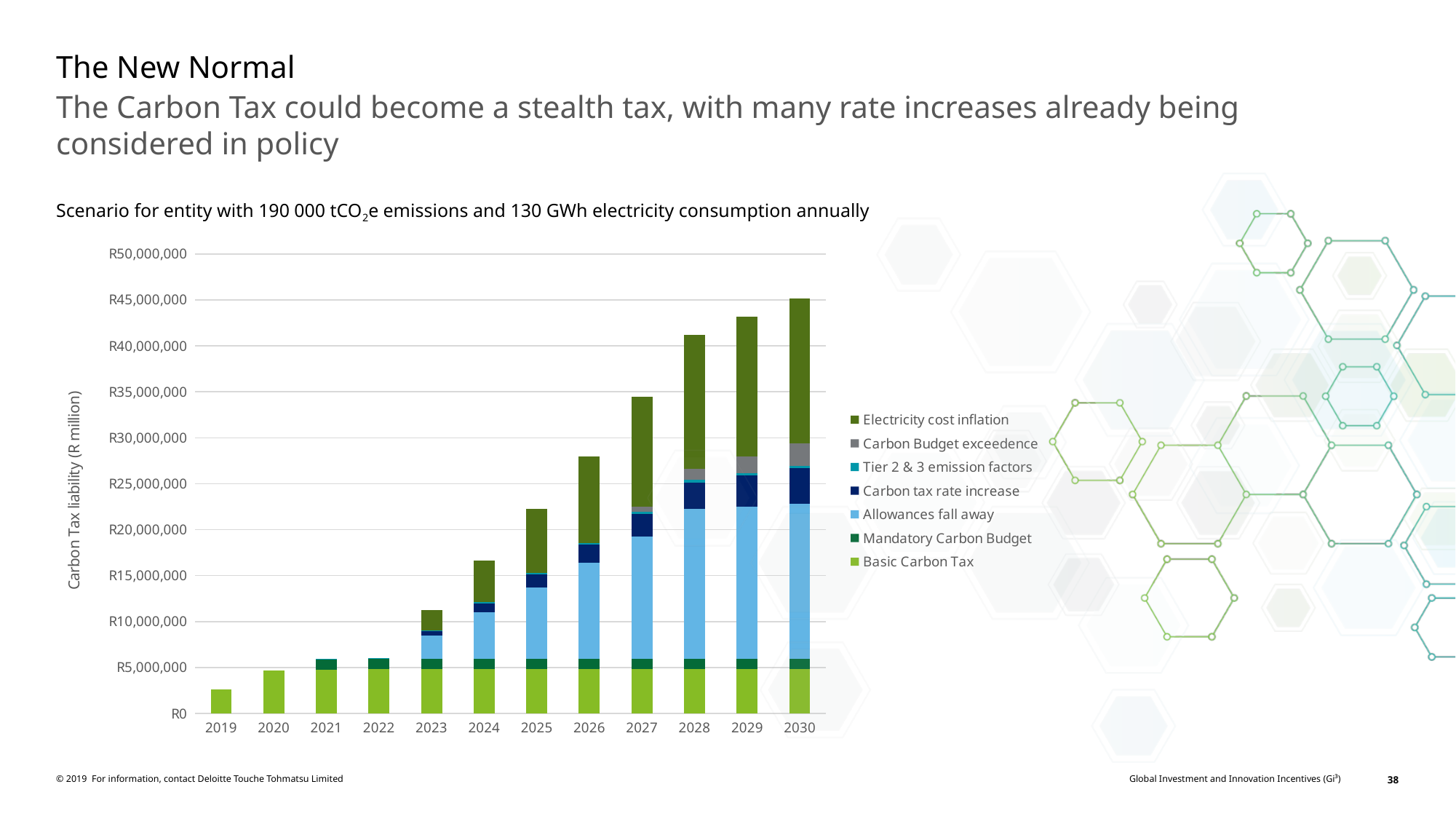
Which year has the lowest total Carbon Tax liability? 2019 Is the total value for 2028 greater or less than R40,000,000? greater Is the total value for 2026 greater or less than R25,000,000? greater Which series is listed first in the chart's legend? Electricity cost inflation What kind of chart is shown on the slide? Stacked bar chart Do the total bar heights rise or fall from 2019 to 2030? Rise Which year has the highest total Carbon Tax liability? 2030 Which year has the larger total Carbon Tax liability, 2024 or 2027? 2027 How many series does the chart's legend list? 7 How many years are shown along the x axis of the chart? 12 Is the total value for 2019 greater or less than R5,000,000? less What is the label on the y axis of the chart? Carbon Tax liability (R million)